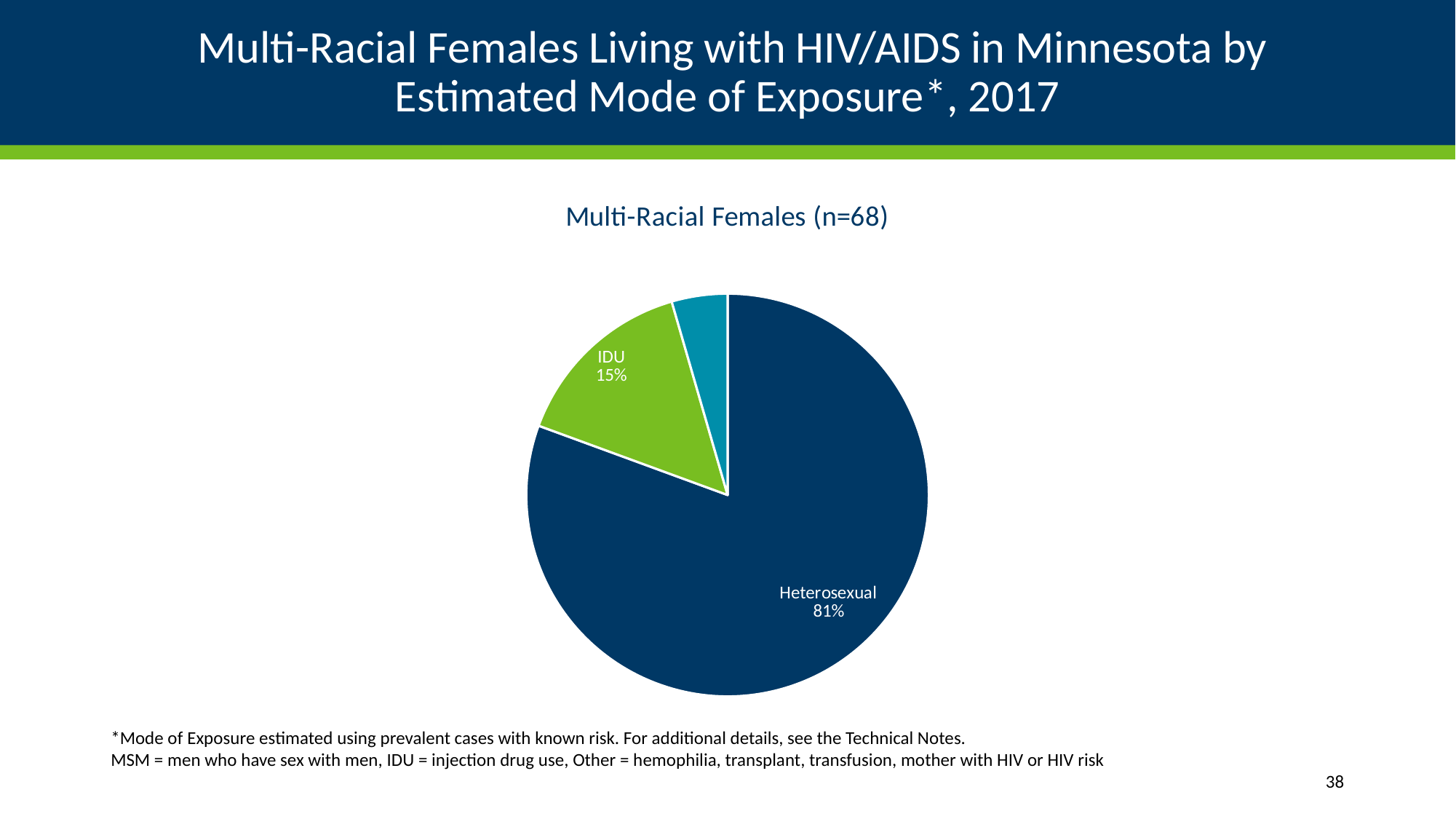
What is the title shown above the pie chart? Multi-Racial Females (n=68) Which of the two labelled slices, Heterosexual or IDU, is smaller? IDU How many slices does the pie chart have? 3 Which labelled slice of the pie is the largest? Heterosexual Is the Heterosexual share greater or less than 50%? greater What colour is the Heterosexual slice of the pie? dark blue What is the sample size (n) given in the chart title? 68 Is the Heterosexual share larger or smaller than the IDU share? larger What is the difference in percentage points between the Heterosexual and IDU shares? 66 What share of the pie is labelled Heterosexual? 81% What share of the pie is labelled IDU? 15% What kind of chart is shown on the slide? pie chart